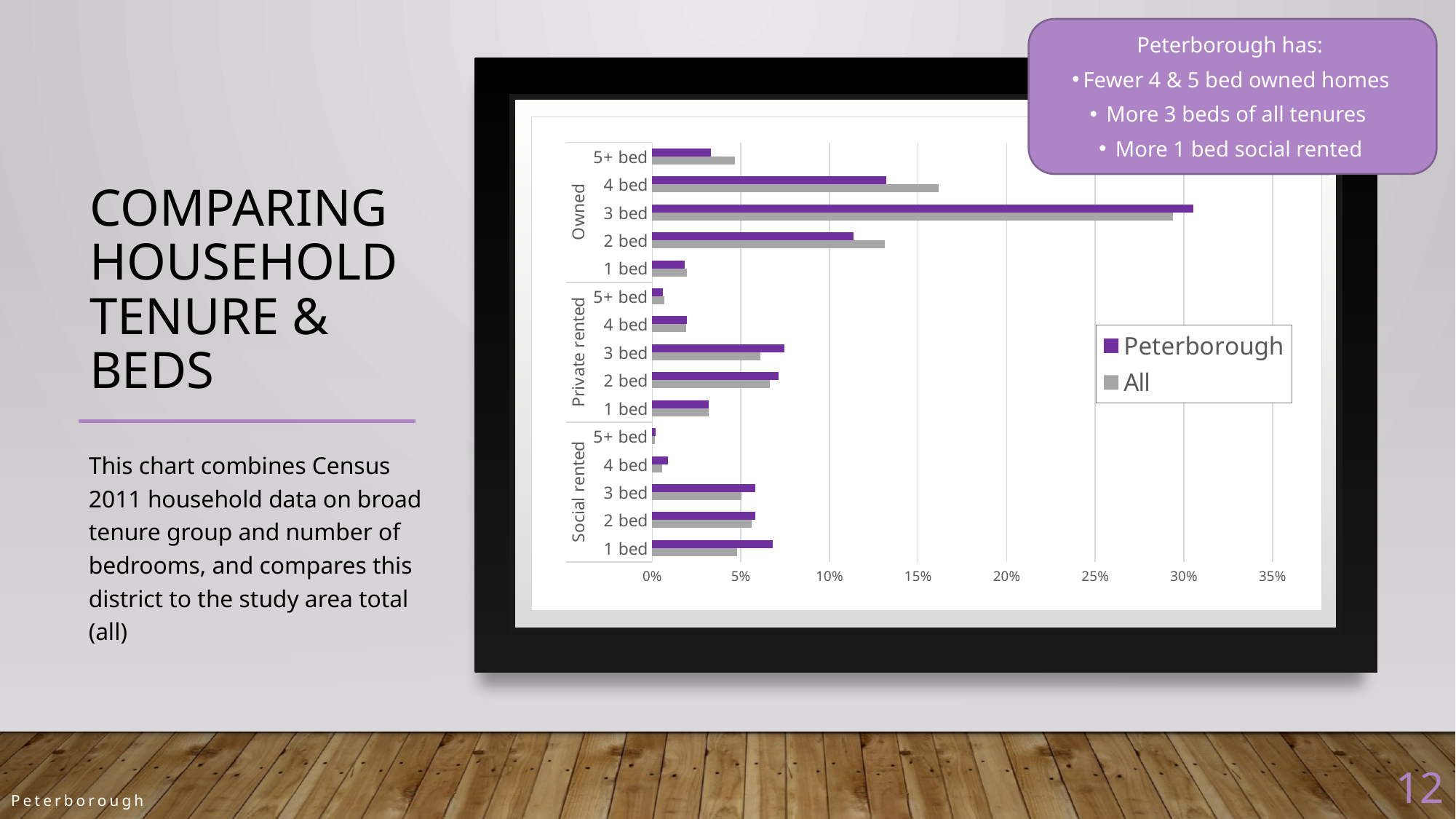
For Social rented 1 bed, which series has the larger value, Peterborough or All? Peterborough What kind of chart is shown on the slide? Bar chart Is the Peterborough value for Owned 3 bed greater or less than 30%? greater What colour are the Peterborough bars in the chart? Purple Which two series are listed in the chart legend? Peterborough and All Is the All value for Owned 4 bed greater or less than 15%? greater Which category has the highest Peterborough value? Owned 3 bed How many series does the chart legend list? 2 Which category has the lowest Peterborough value? Social rented 5+ bed How many bedroom categories are plotted in total across the three tenure groups? 15 For Owned 4 bed, which series has the larger value, Peterborough or All? All Is the Peterborough value for Owned 4 bed greater or less than 15%? less